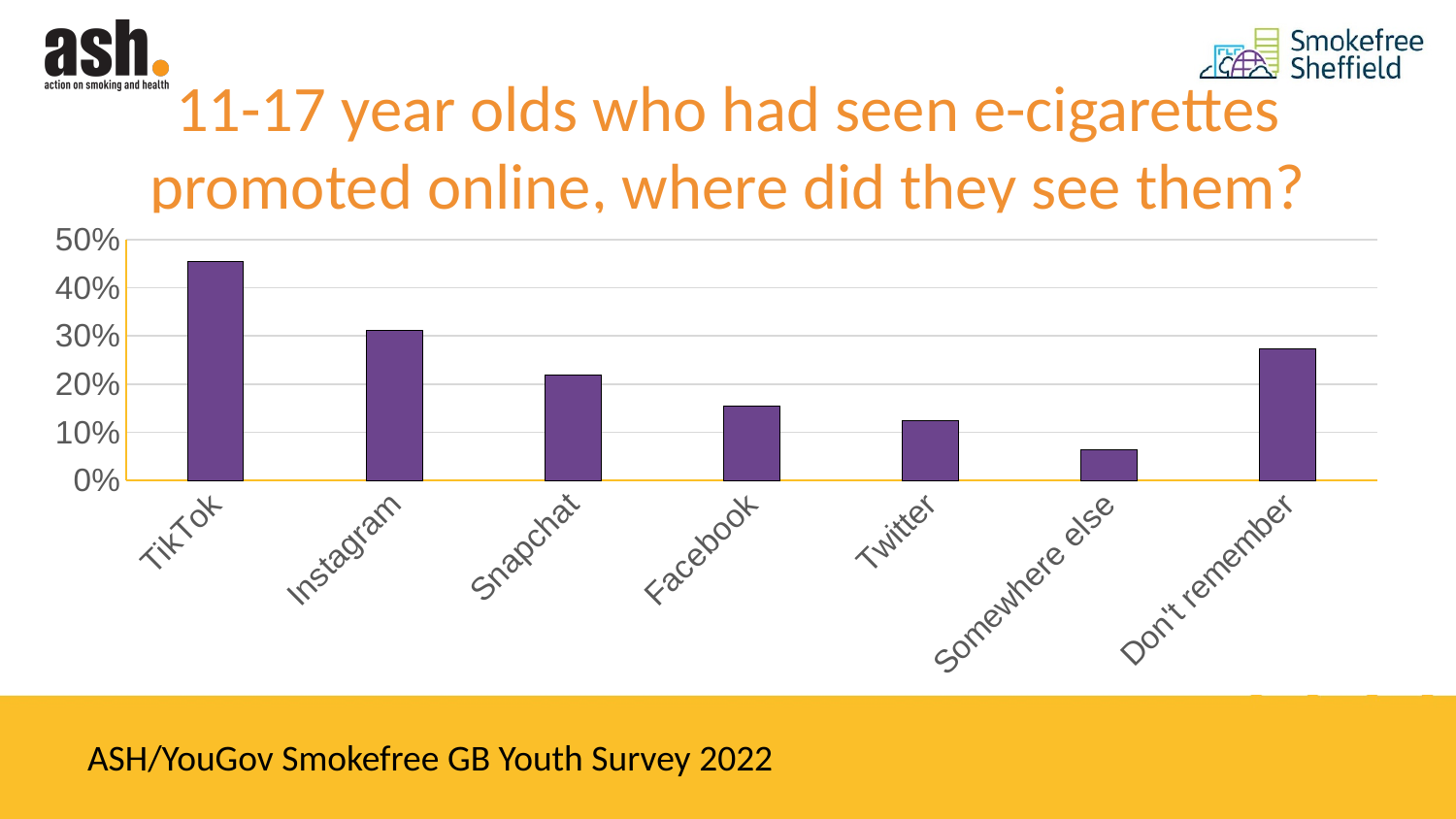
Which is larger, the value for Facebook or the value for Twitter? Facebook Is the value for Don't remember greater or less than 20%? greater How many categories are shown on the x axis of the chart? 7 Is the value for Instagram greater or less than 30%? greater Which category has the highest value in the chart? TikTok Is the value for Somewhere else greater or less than 10%? less Which is larger, the value for Snapchat or the value for Don't remember? Don't remember What kind of chart is shown on the slide? bar chart What is the title of the chart on the slide? 11-17 year olds who had seen e-cigarettes promoted online, where did they see them? Which category has the lowest value in the chart? Somewhere else